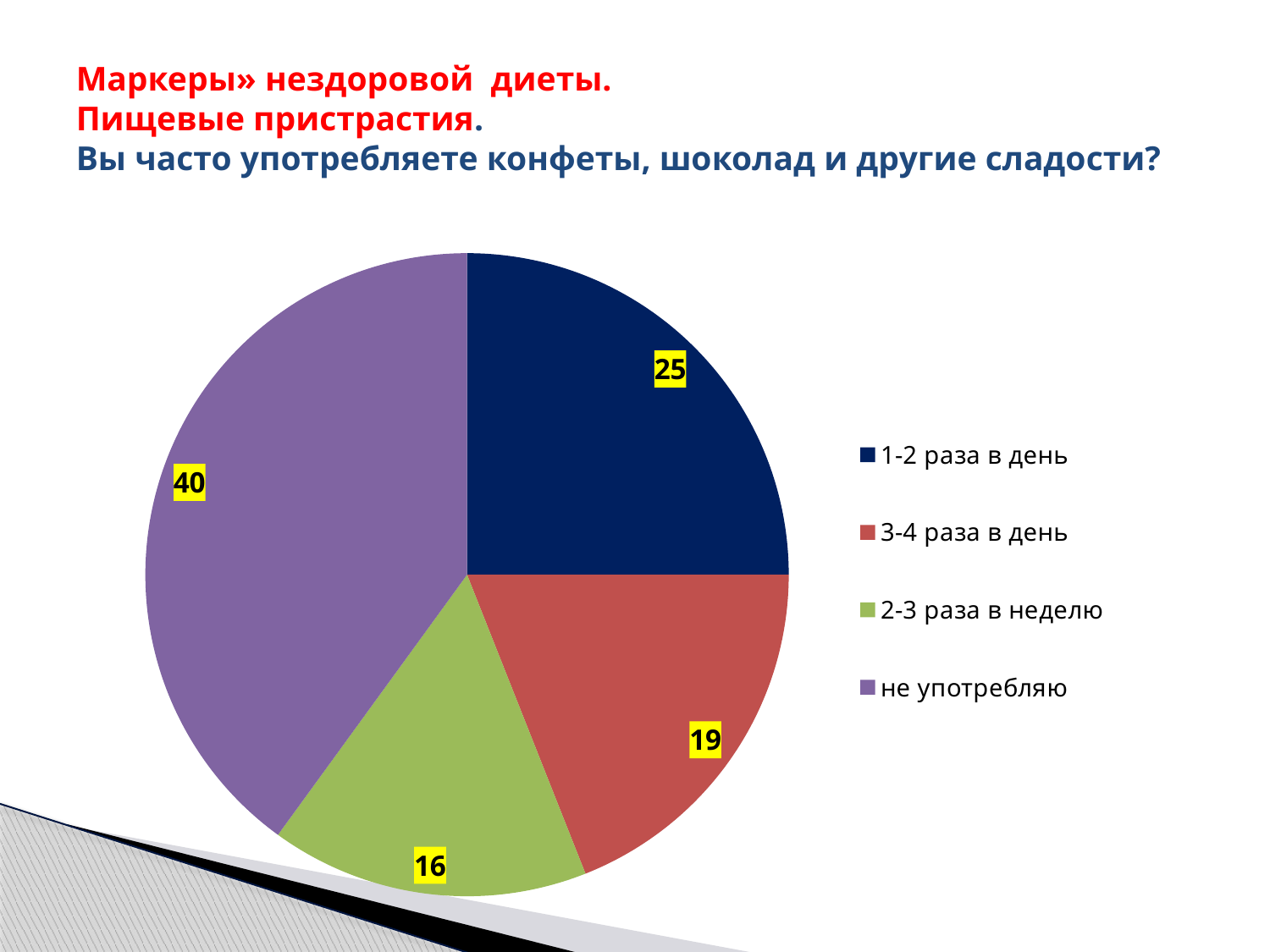
What is the difference between the values for "не употребляю" and "1-2 раза в день"? 15 Which is larger, the value for "3-4 раза в день" or "2-3 раза в неделю"? 3-4 раза в день Which category has the largest slice? не употребляю What is the value for "не употребляю"? 40 What share of the pie does "не употребляю" represent? 40% What colour is the slice for "2-3 раза в неделю"? green What is the value for "1-2 раза в день"? 25 What is the value for "3-4 раза в день"? 19 How many slices does the pie chart have? 4 Which category has the smallest slice? 2-3 раза в неделю What is the value for "2-3 раза в неделю"? 16 What kind of chart is shown on the slide? pie chart